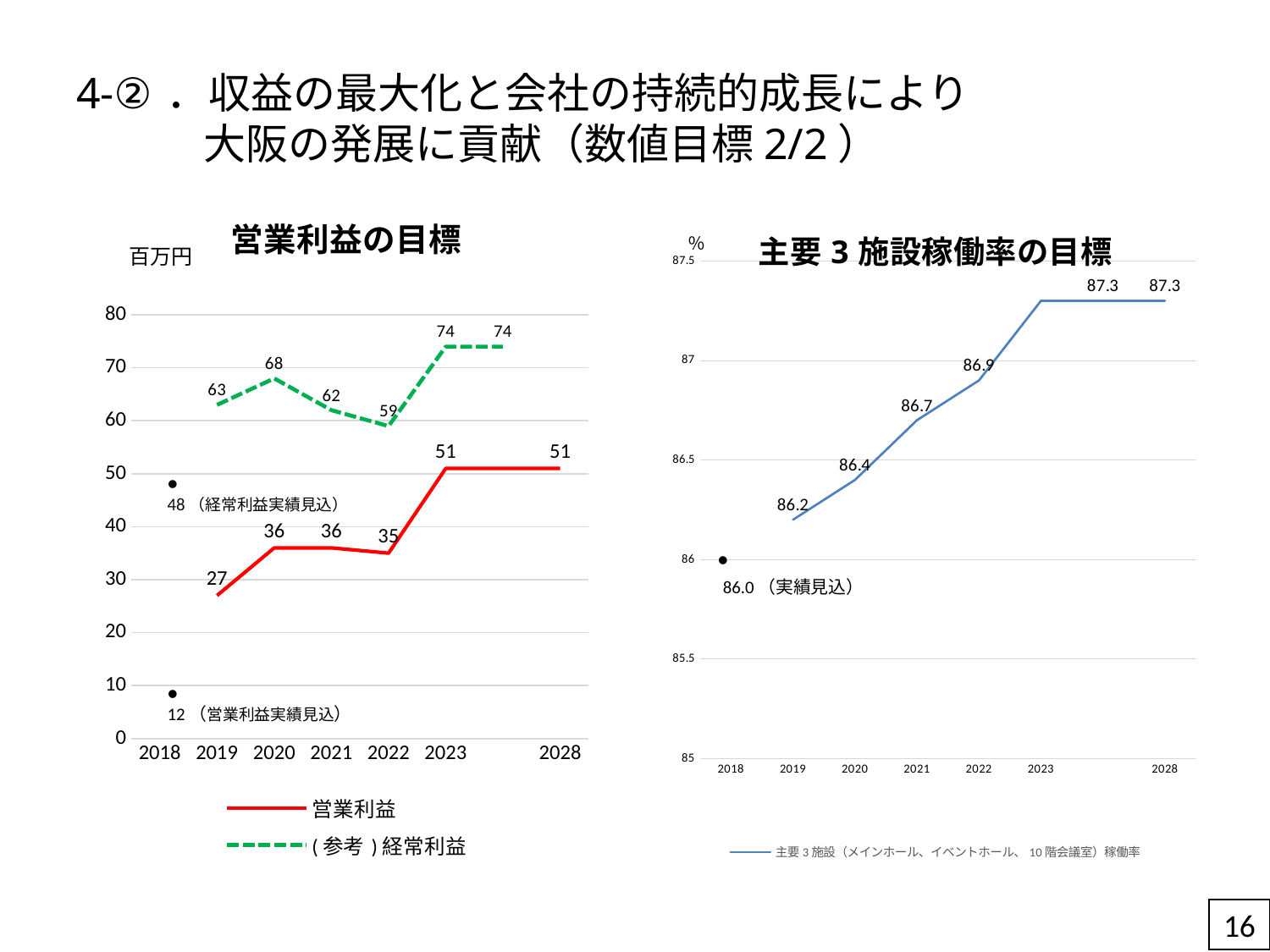
In the 営業利益の目標 chart, what is the (参考)経常利益 value for 2020? 68 In the 主要3施設稼働率の目標 chart, do the values rise or fall from 2019 to 2023? rise In the 営業利益の目標 chart, what unit is shown at the top of the vertical axis? 百万円 In the 営業利益の目標 chart, what is the difference between the (参考)経常利益 and 営業利益 values in 2022? 24 In the 営業利益の目標 chart, which year has the lowest (参考)経常利益 value among the plotted line points (2019–2028)? 2022 In the 営業利益の目標 chart, what is the 営業利益 value for 2023? 51 In the 営業利益の目標 chart, what is the 営業利益 value for 2019? 27 In the 主要3施設稼働率の目標 chart, what is the difference between the 2023 value and the 2019 value? 1.1 What kind of chart is the 主要3施設稼働率の目標 chart? line chart In the 営業利益の目標 chart, how many series does the legend list? 2 In the 主要3施設稼働率の目標 chart, what is the value for 2021? 86.7 In the 主要3施設稼働率の目標 chart, what is the value for 2028? 87.3